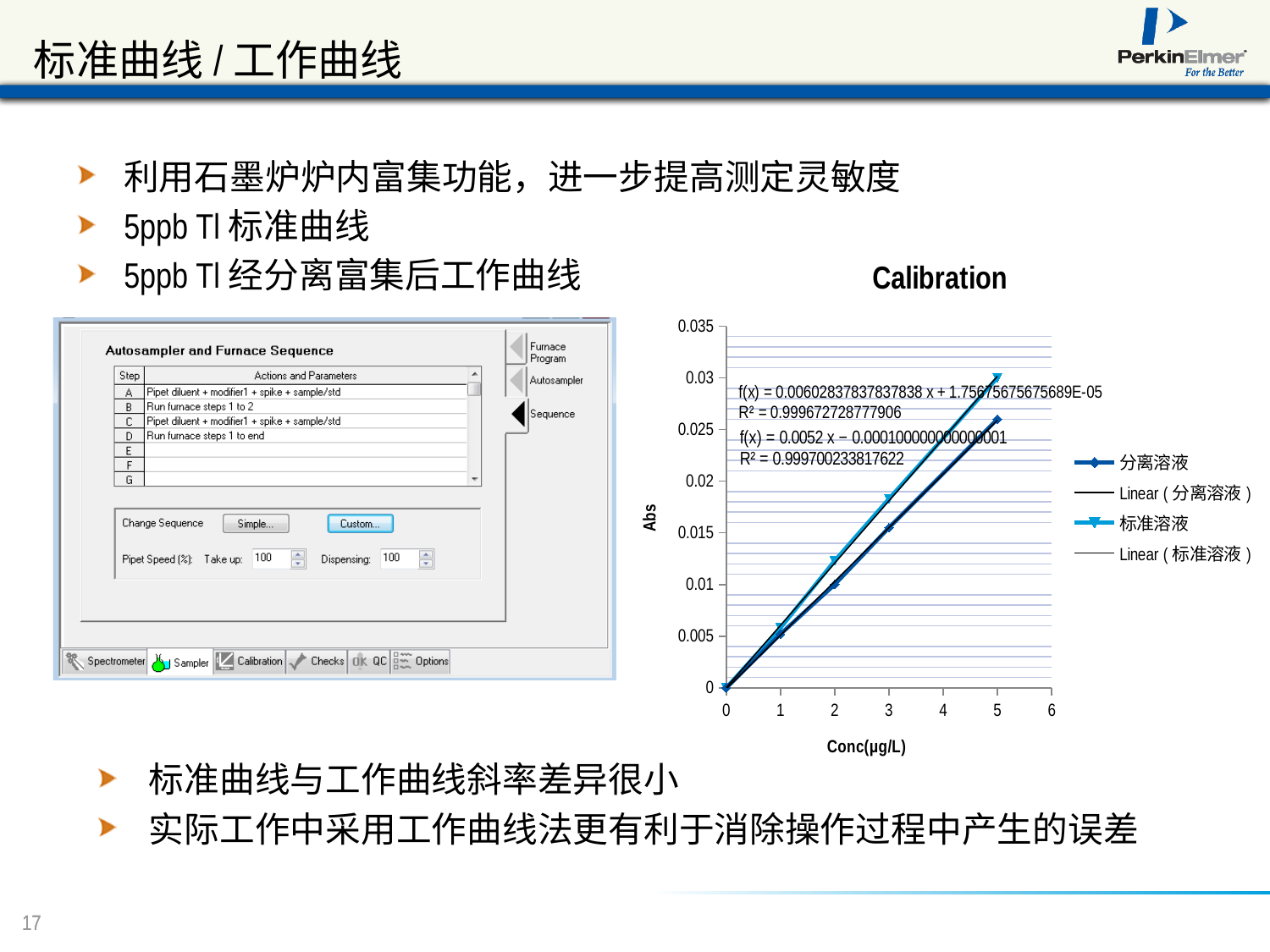
In the Calibration chart, is the value for 分离溶液 at concentration 5 greater or less than 0.02? greater What is the title of the chart on the right of the slide? Calibration What is the x-axis title of the Calibration chart? Conc(µg/L) In the Calibration chart, is the value for 分离溶液 at concentration 1 greater or less than 0.01? less In the Calibration chart, is the value for 标准溶液 at concentration 3 greater or less than 0.015? greater In the Calibration chart, what is the R² value shown for the steeper trendline (slope 0.00602837837837838)? 0.999672728777906 What kind of chart is the Calibration chart? line chart How many entries does the legend of the Calibration chart list? 4 In the Calibration chart, what is the R² value shown for the trendline with slope 0.0052? 0.999700233817622 In the Calibration chart, which series has the higher Abs value at concentration 5, 分离溶液 or 标准溶液? 标准溶液 In the Calibration chart, do the Abs values rise or fall as concentration increases? rise